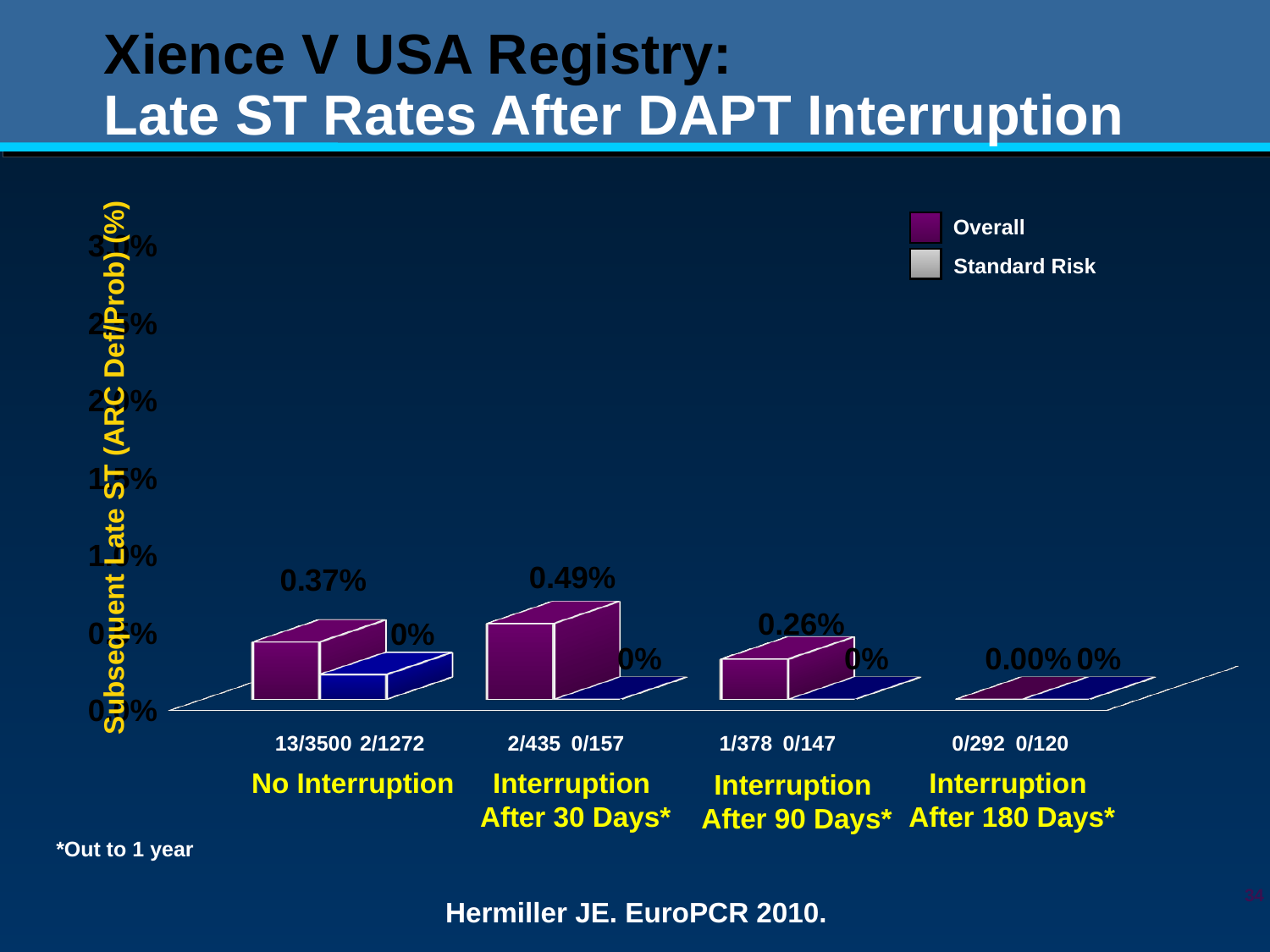
Which has a higher Overall late ST rate: No Interruption or Interruption After 90 Days*? No Interruption What is the Overall subsequent late ST rate for the No Interruption group? 0.37% Which category has the lowest Overall late ST rate? Interruption After 180 Days* How many series does the legend list? 2 Is the Overall late ST rate for No Interruption greater or less than 1.0%? less What is the difference between the Overall late ST rate for Interruption After 30 Days* and for No Interruption? 0.12% What is the Overall subsequent late ST rate for Interruption After 30 Days*? 0.49% What kind of chart is shown on the slide? Bar chart Which category has the highest Overall late ST rate? Interruption After 30 Days* What is the Overall subsequent late ST rate for Interruption After 180 Days*? 0.00% How many categories are shown on the x axis of the chart? 4 What is the Overall subsequent late ST rate for Interruption After 90 Days*? 0.26%